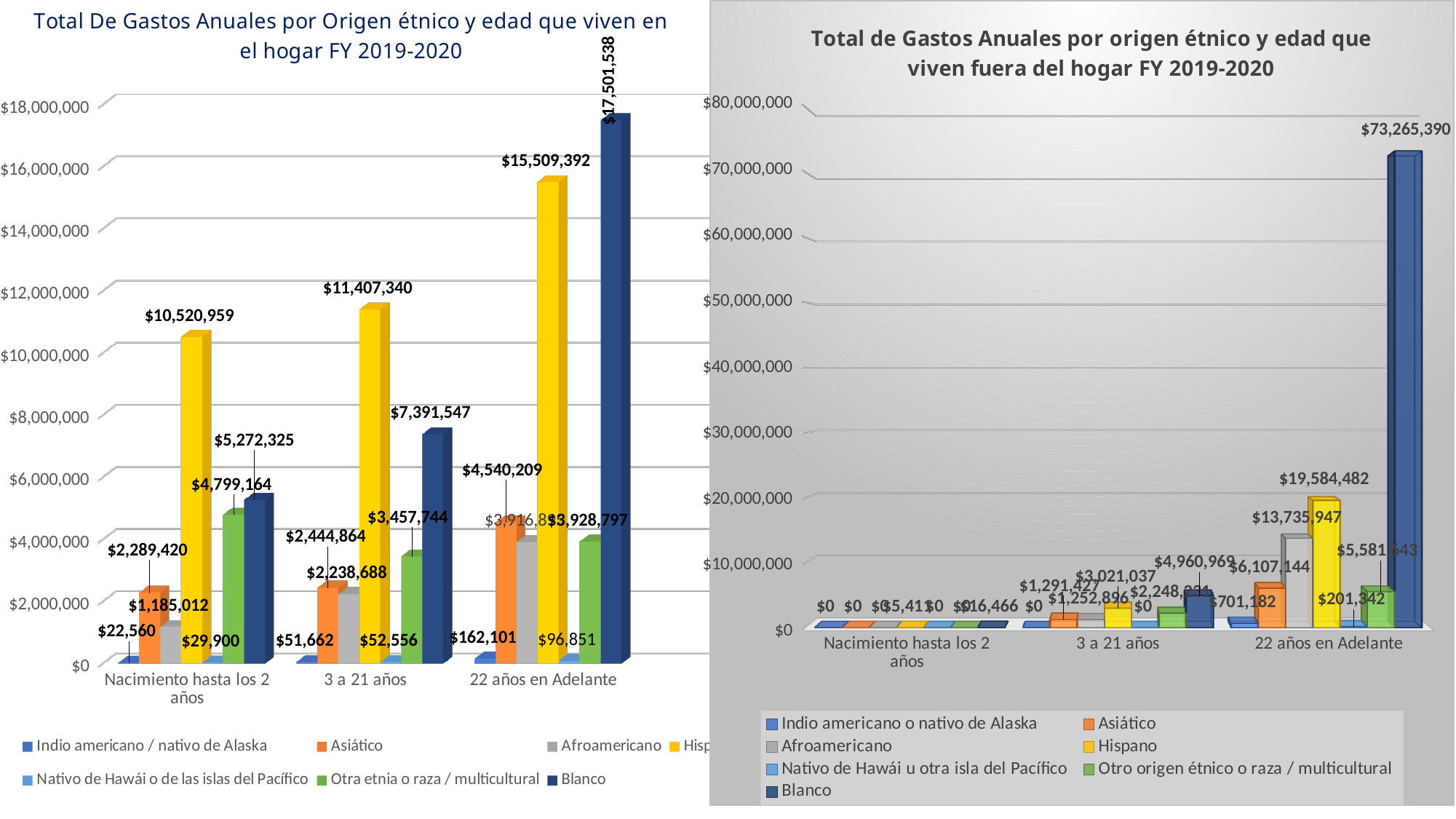
In the left chart (viven en el hogar), what is the difference between the Blanco values for '22 años en Adelante' and '3 a 21 años'? $10,109,991 In the right chart (viven fuera del hogar), what is the value for Blanco in the '22 años en Adelante' category? $73,265,390 In the left chart (viven en el hogar), what is the value for Blanco in the '22 años en Adelante' category? $17,501,538 In the left chart (viven en el hogar), which series has the highest value in the '3 a 21 años' category? Hispano What kind of chart is the right chart (viven fuera del hogar)? Bar chart How many series does the legend of the right chart (viven fuera del hogar) list? 7 In the right chart (viven fuera del hogar), what is the value for Hispano in the '22 años en Adelante' category? $19,584,482 In the right chart (viven fuera del hogar), which series has the highest value in the '22 años en Adelante' category? Blanco How many age categories are shown on the x axis of the left chart (viven en el hogar)? 3 In the left chart (viven en el hogar), which is larger for 'Nacimiento hasta los 2 años': Blanco or Otra etnia o raza / multicultural? Blanco In the right chart (viven fuera del hogar), is the value for Afroamericano in '22 años en Adelante' greater or less than $10,000,000? greater In the left chart (viven en el hogar), what is the value for Hispano in the 'Nacimiento hasta los 2 años' category? $10,520,959